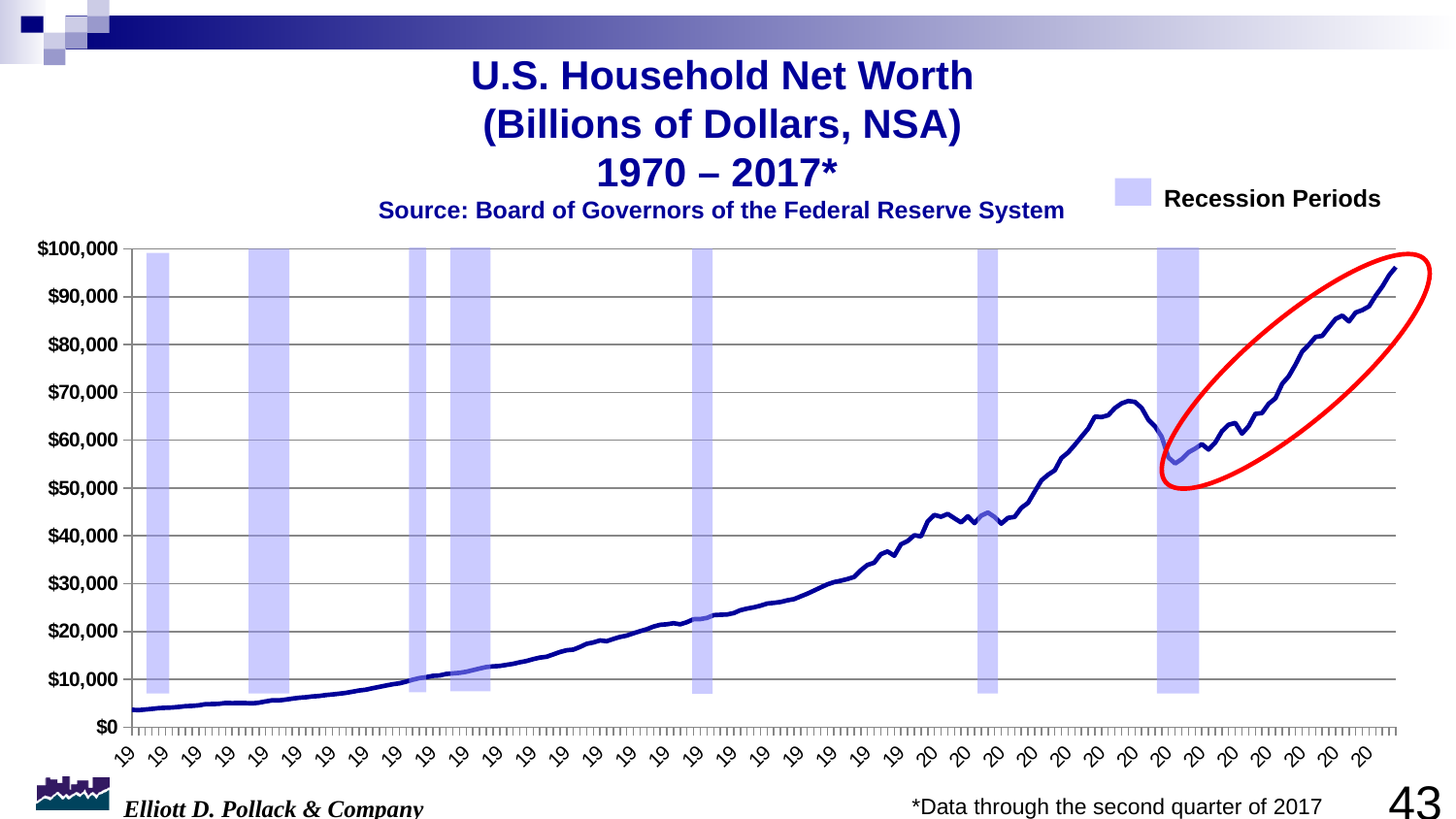
What is the highest value labeled on the vertical axis? $100,000 What is the title of the chart? U.S. Household Net Worth (Billions of Dollars, NSA) 1970 – 2017* Is the value at the far right end of the line greater or less than $100,000? less Is the value at the far left start of the line greater or less than $10,000? less Overall, does U.S. household net worth rise or fall from the left of the chart to the right? Rise What do the shaded vertical bands on the chart represent, according to the legend? Recession Periods Is the lowest point of the line within the last (rightmost) shaded recession period greater or less than $60,000? less What kind of chart is shown on the slide? Line chart Which end of the line is higher, the left end or the right end? Right end